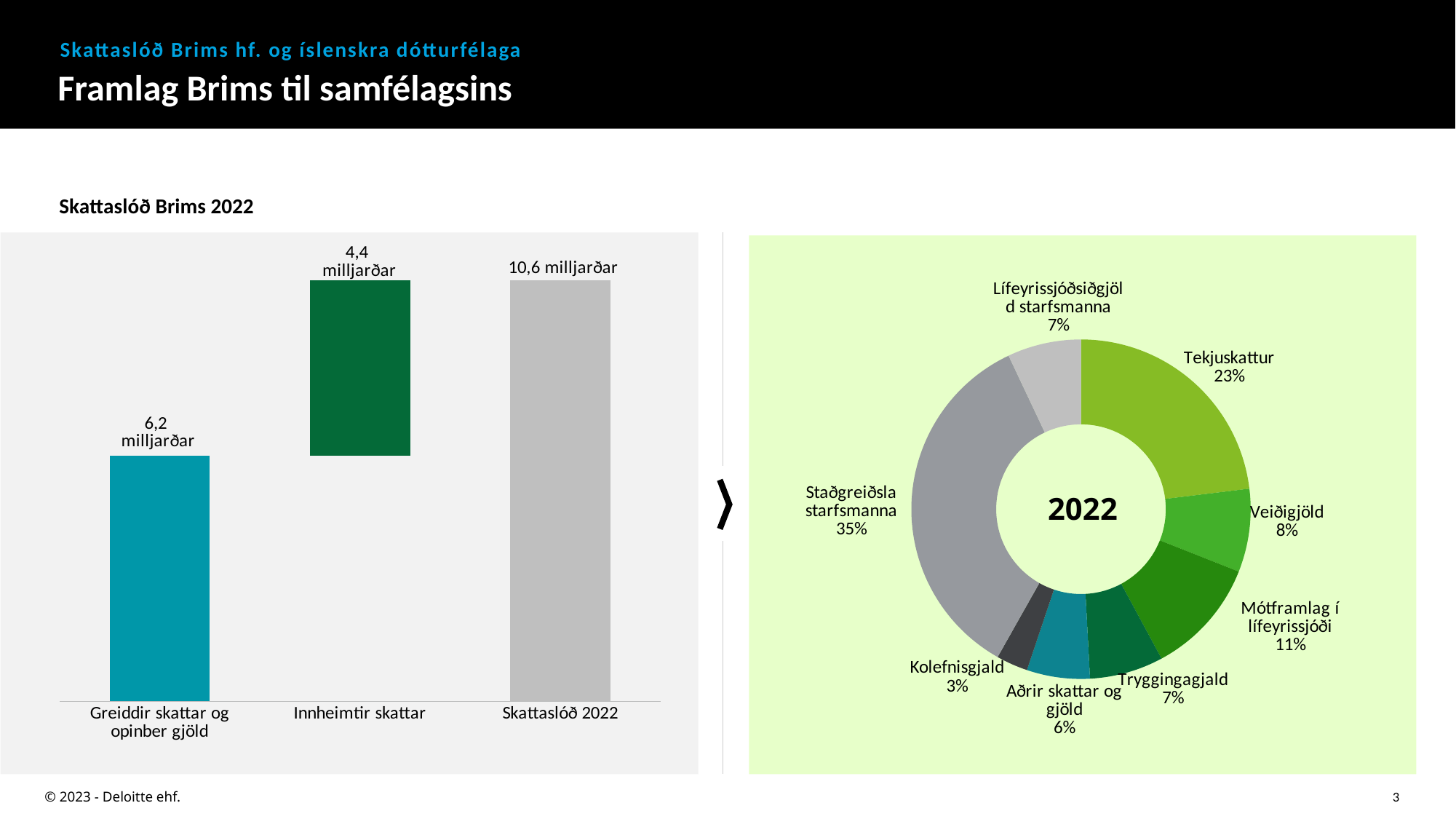
In the bar chart on the left, how many categories are shown on the x axis? 3 In the donut chart on the right, what share does Tekjuskattur have? 23% In the bar chart on the left, what is the value for Innheimtir skattar? 4,4 milljarðar In the bar chart on the left, what is the value for Skattaslóð 2022? 10,6 milljarðar In the donut chart on the right, how many categories are shown? 8 In the bar chart on the left, what is the value for Greiddir skattar og opinber gjöld? 6,2 milljarðar In the donut chart on the right, which category has the smallest share? Kolefnisgjald In the bar chart on the left, which category has the lowest value? Innheimtir skattar In the donut chart on the right, what share does Staðgreiðsla starfsmanna have? 35% In the donut chart on the right, which category has the largest share? Staðgreiðsla starfsmanna What kind of chart is the chart on the left of the slide? Bar chart In the donut chart on the right, what is the difference in percentage points between Mótframlag í lífeyrissjóði and Veiðigjöld? 3